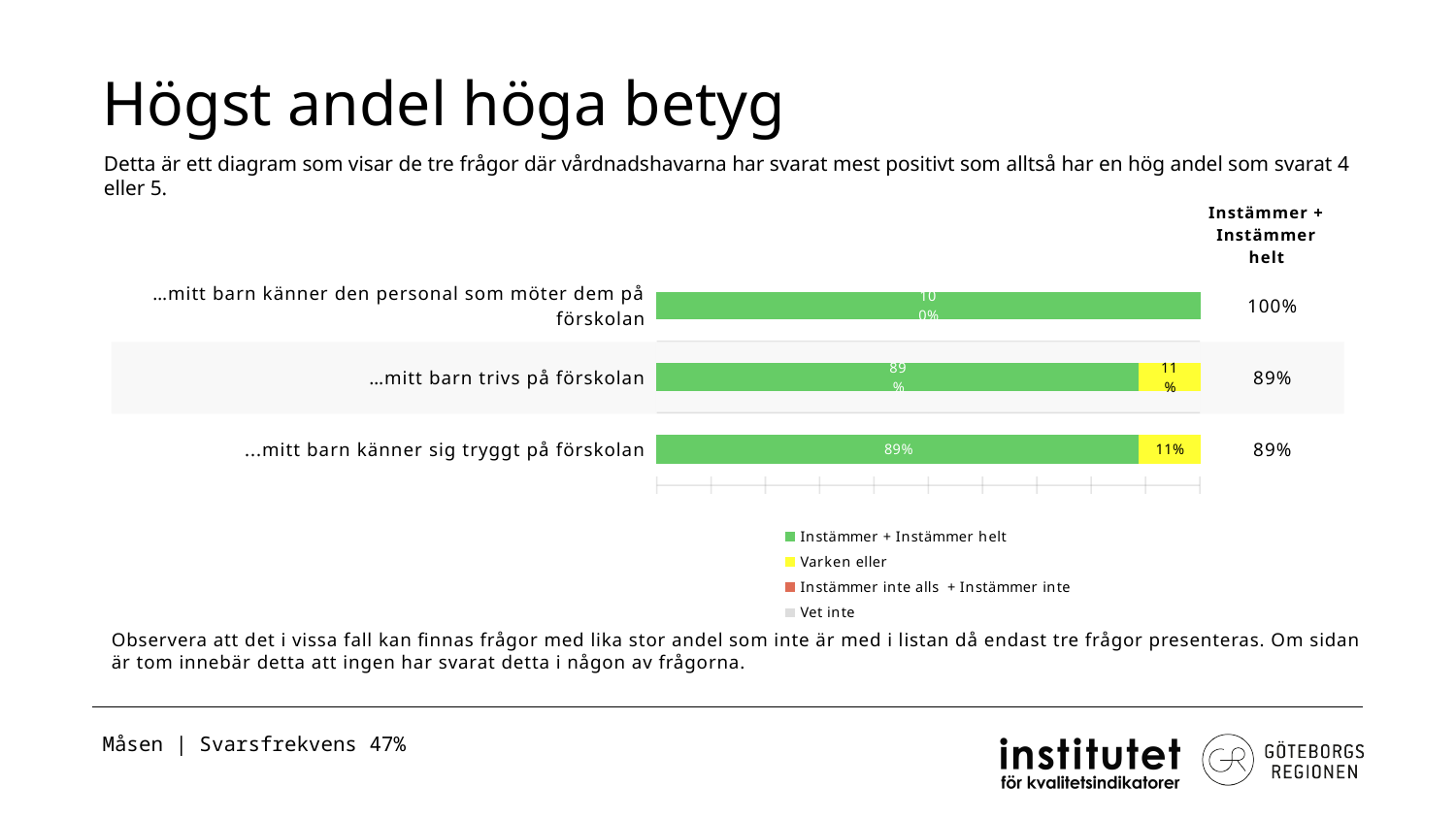
What is the difference between the 'Instämmer + Instämmer helt' share for '…mitt barn känner den personal som möter dem på förskolan' and for '…mitt barn trivs på förskolan'? 11% Which is larger: the 'Instämmer + Instämmer helt' share for '…mitt barn trivs på förskolan' or the 'Varken eller' share for the same question? Instämmer + Instämmer helt Which category has the highest 'Instämmer + Instämmer helt' share? …mitt barn känner den personal som möter dem på förskolan How many categories (questions) are plotted in the chart? 3 What is the title of the slide containing the chart? Högst andel höga betyg What is the 'Instämmer + Instämmer helt' value for '…mitt barn känner den personal som möter dem på förskolan'? 100% What is the 'Varken eller' value for '...mitt barn känner sig tryggt på förskolan'? 11% What colour represents 'Varken eller' in the chart? yellow What type of chart is shown on the slide? bar chart How many series does the legend list? 4 What is the 'Instämmer + Instämmer helt' value for '…mitt barn trivs på förskolan'? 89% What is the total of the stacked bar for '...mitt barn känner sig tryggt på förskolan'? 100%